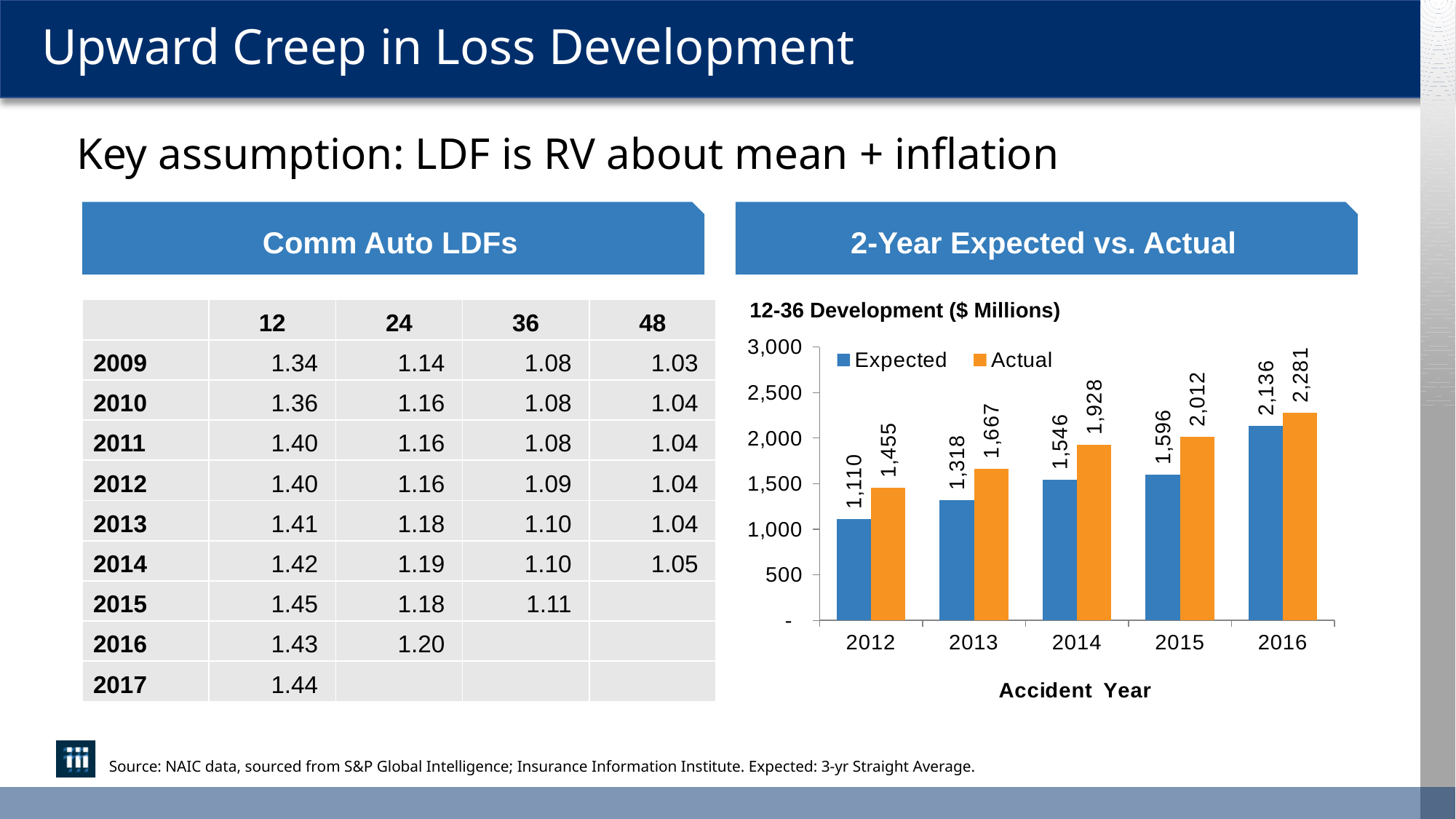
What is the Actual value for 2016 in the 12-36 Development chart? 2,281 How many accident years are shown in the 12-36 Development chart? 5 What is the difference between the Actual and Expected values for 2012 in the 12-36 Development chart? 345 Which accident year has the lowest Expected value in the 12-36 Development chart? 2012 What is the Actual value for 2013 in the 12-36 Development chart? 1,667 Do the Expected values in the 12-36 Development chart rise or fall from 2012 to 2016? Rise What kind of chart is the 12-36 Development chart? Bar chart Which accident year has the highest Actual value in the 12-36 Development chart? 2016 How many series does the legend of the 12-36 Development chart list? 2 In the 12-36 Development chart, which is larger for 2014: the Expected or the Actual value? Actual What is the difference between the Actual and Expected values for 2015 in the 12-36 Development chart? 416 What is the Expected value for 2014 in the 12-36 Development chart? 1,546